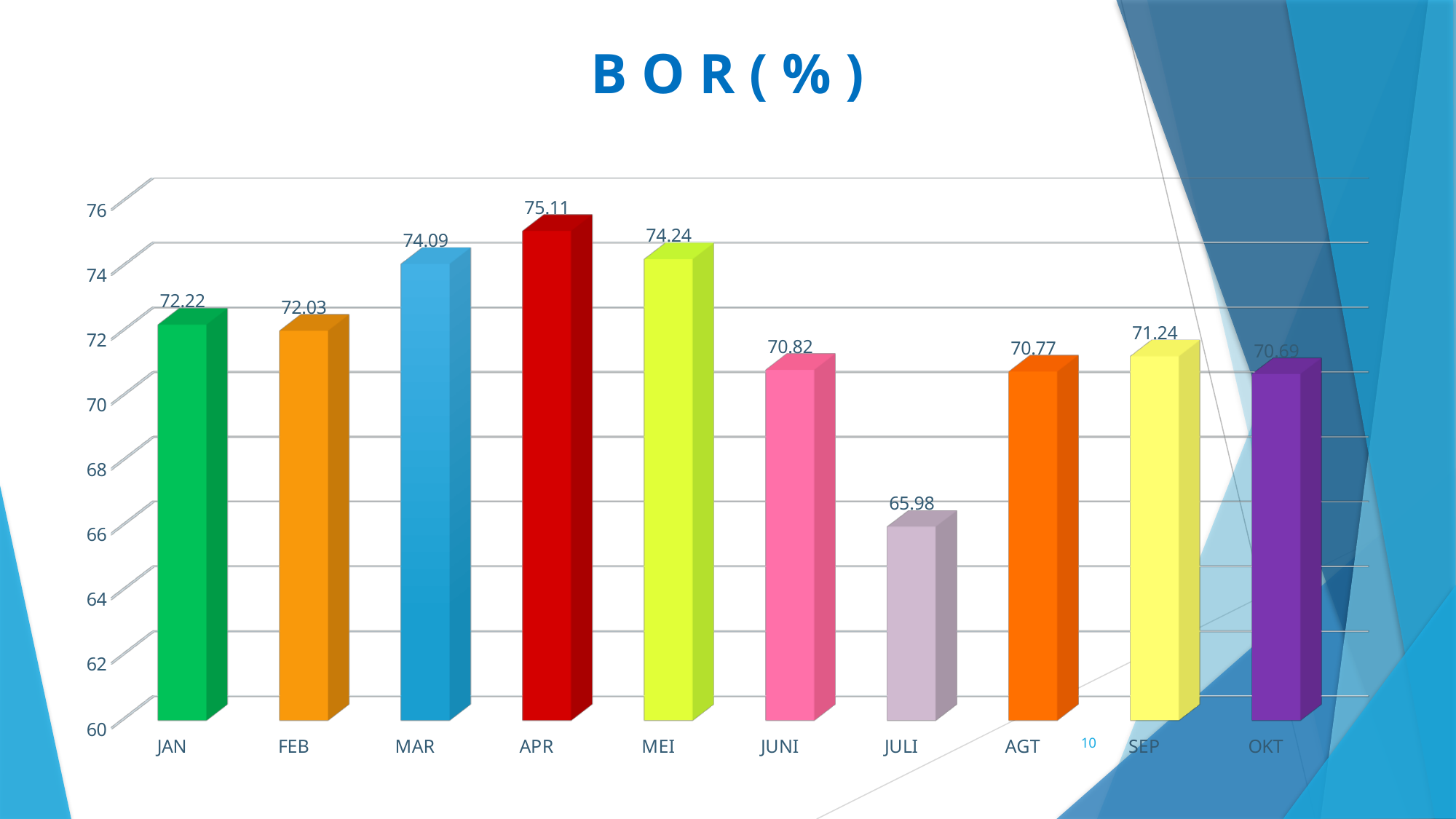
Which month has a higher BOR (%), JAN or MAR? MAR Which month has the highest BOR (%)? APR How many months are shown on the x axis of the chart? 10 Which month has the lowest BOR (%)? JULI What is the BOR (%) value for APR? 75.11 What is the difference between the BOR (%) values for MAR and MEI? 0.15 What kind of chart is shown on the slide? bar chart What is the BOR (%) value for JULI? 65.98 Is the BOR (%) value for JUNI greater or less than 72? less What is the BOR (%) value for SEP? 71.24 What is the title of the chart? B O R ( % ) What is the difference between the BOR (%) values for APR and JULI? 9.13